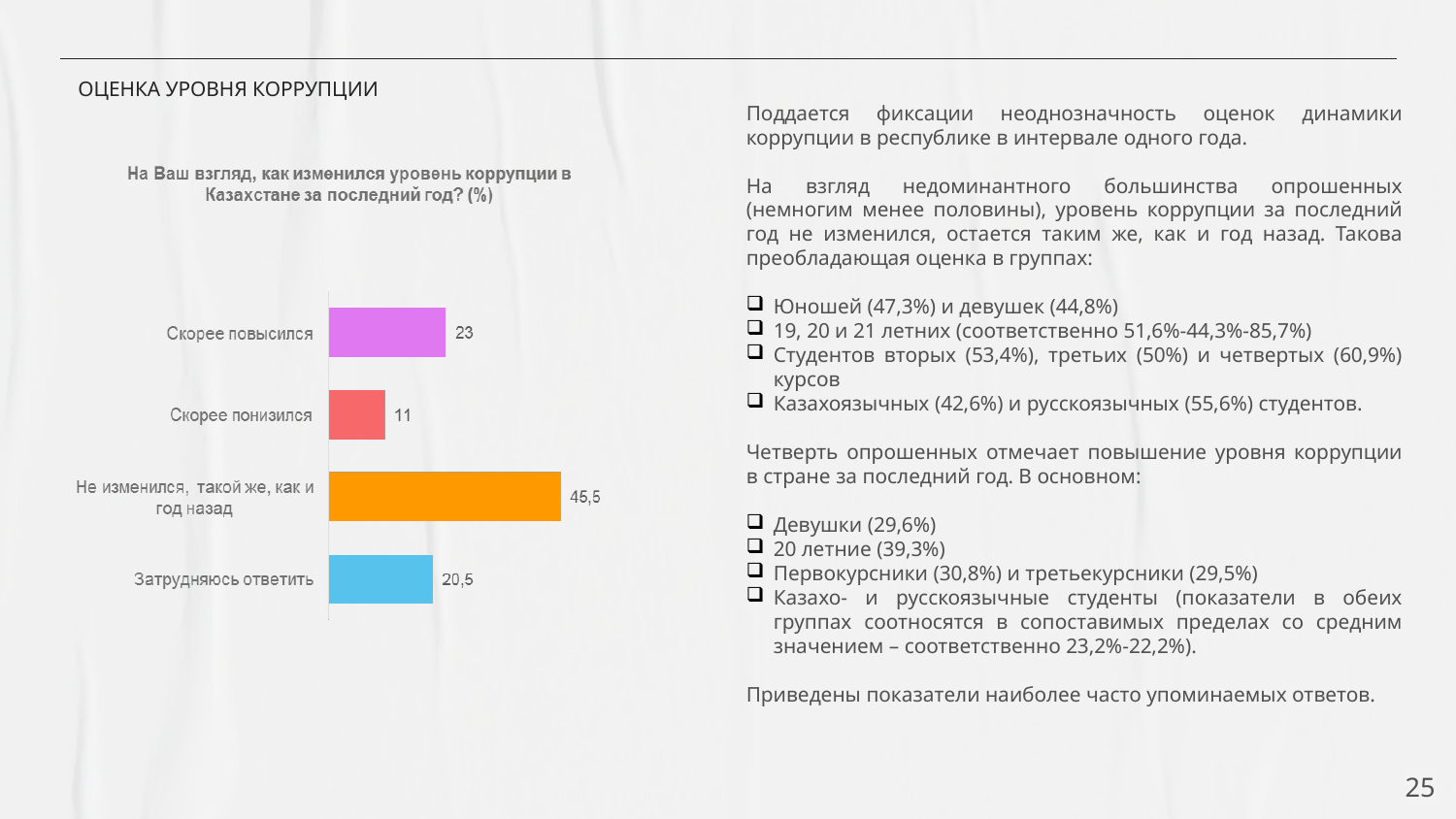
What is the difference between the values for "Не изменился, такой же, как и год назад" and "Затрудняюсь ответить"? 25 What is the difference between the values for "Скорее повысился" and "Скорее понизился"? 12 Which is larger: the value for "Скорее повысился" or the value for "Затрудняюсь ответить"? Скорее повысился What is the value for "Не изменился, такой же, как и год назад"? 45,5 Which category has the lowest value? Скорее понизился What is the value for "Затрудняюсь ответить"? 20,5 What is the title of the chart? На Ваш взгляд, как изменился уровень коррупции в Казахстане за последний год? (%) How many categories are shown in the chart? 4 What is the value for "Скорее повысился"? 23 What kind of chart is shown on the slide? Bar chart Which category has the highest value? Не изменился, такой же, как и год назад What is the value for "Скорее понизился"? 11